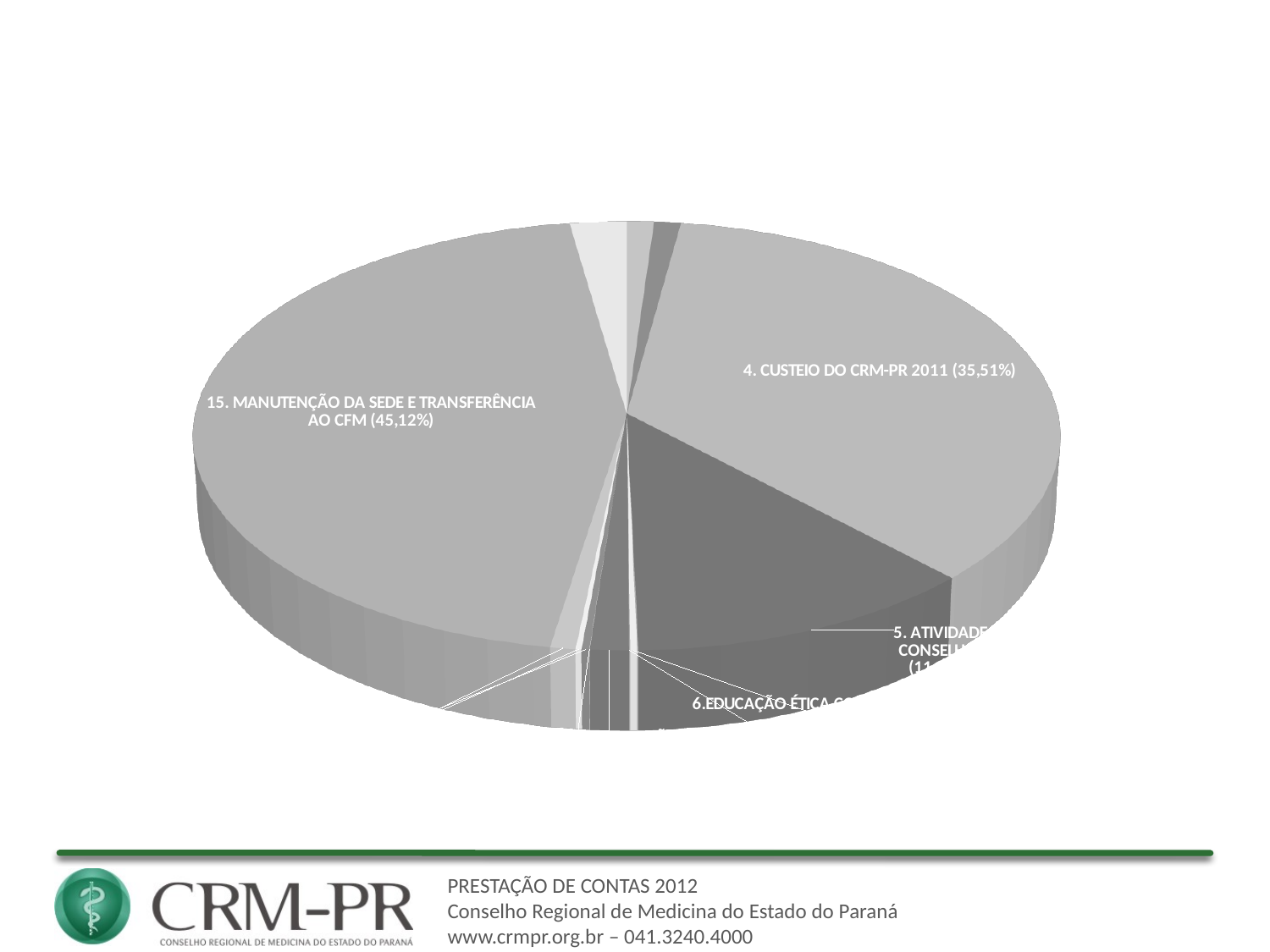
What share of the pie does "4. CUSTEIO DO CRM-PR 2011" represent? 35,51% What kind of chart is shown on the slide? pie chart Which is larger: the slice for "4. CUSTEIO DO CRM-PR 2011" or the slice for "15. MANUTENÇÃO DA SEDE E TRANSFERÊNCIA AO CFM"? 15. MANUTENÇÃO DA SEDE E TRANSFERÊNCIA AO CFM What is the combined share of the "15. MANUTENÇÃO DA SEDE E TRANSFERÊNCIA AO CFM" and "4. CUSTEIO DO CRM-PR 2011" slices? 80,63% What is the difference in percentage points between the "15. MANUTENÇÃO DA SEDE E TRANSFERÊNCIA AO CFM" slice and the "4. CUSTEIO DO CRM-PR 2011" slice? 9,61% Is the share for "4. CUSTEIO DO CRM-PR 2011" greater or less than 50%? less What share of the pie does "15. MANUTENÇÃO DA SEDE E TRANSFERÊNCIA AO CFM" represent? 45,12% Which category has the largest slice of the pie? 15. MANUTENÇÃO DA SEDE E TRANSFERÊNCIA AO CFM Is the pie chart drawn in 3D or flat 2D? 3D